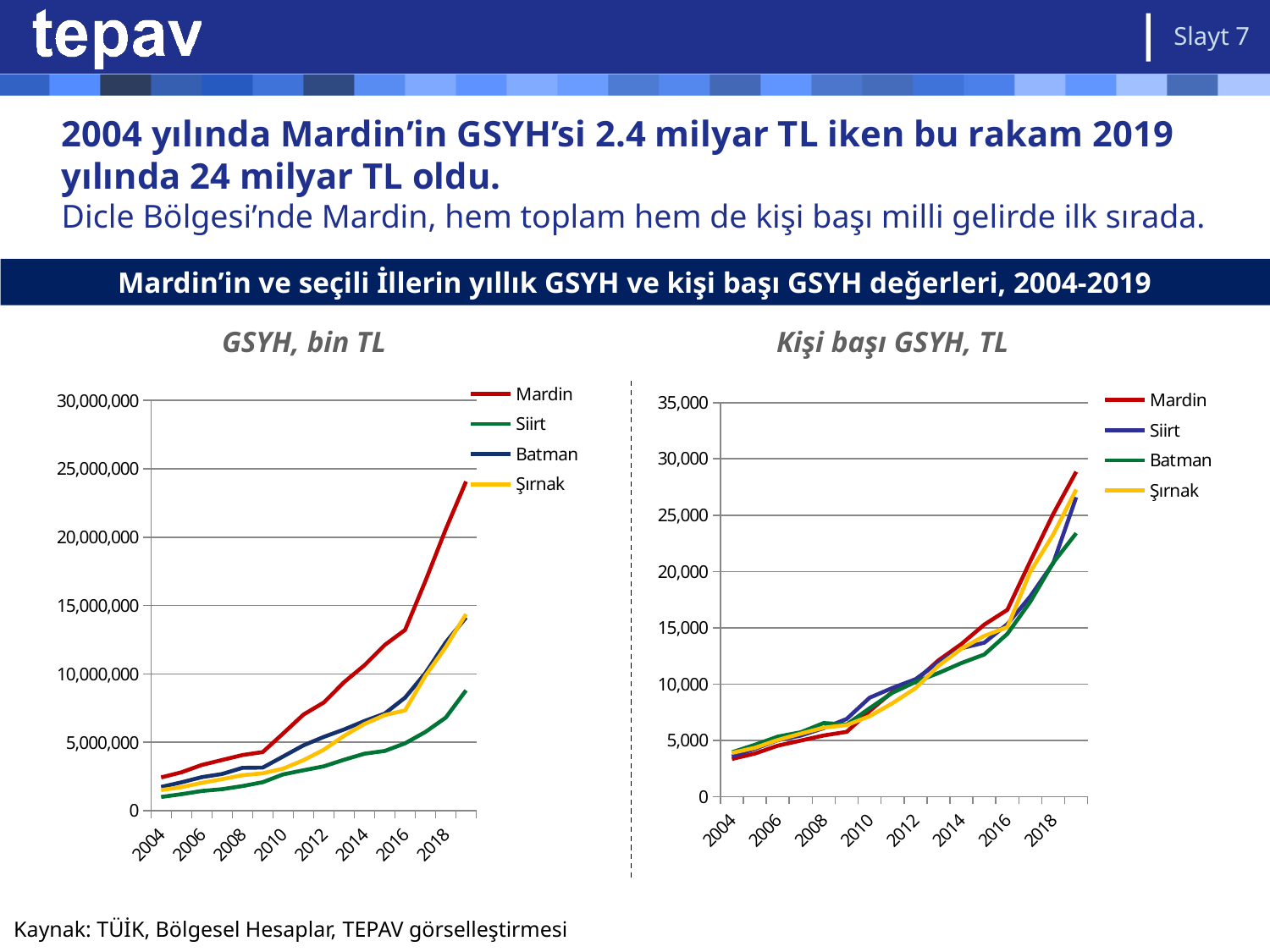
In the 'GSYH, bin TL' chart, which province has the lowest value in 2019? Siirt In the 'GSYH, bin TL' chart, does the Mardin line rise or fall from 2004 to 2019? rise In the 'Kişi başı GSYH, TL' chart, is the value for Mardin in 2019 greater or less than 25,000? greater In the 'GSYH, bin TL' chart, is the value for Siirt in 2019 greater or less than 10,000,000? less What kind of chart is the 'Kişi başı GSYH, TL' chart on the right? line chart In the 'Kişi başı GSYH, TL' chart, which province has the highest value in 2019? Mardin In the 'GSYH, bin TL' chart, is the value for Mardin in 2019 greater or less than 20,000,000? greater In the 'Kişi başı GSYH, TL' chart, which province has the lowest value in 2019? Batman What kind of chart is the 'GSYH, bin TL' chart on the left? line chart How many series does the legend of the 'Kişi başı GSYH, TL' chart list? 4 In the 'GSYH, bin TL' chart, which province has the highest value in 2019? Mardin How many series does the legend of the 'GSYH, bin TL' chart list? 4